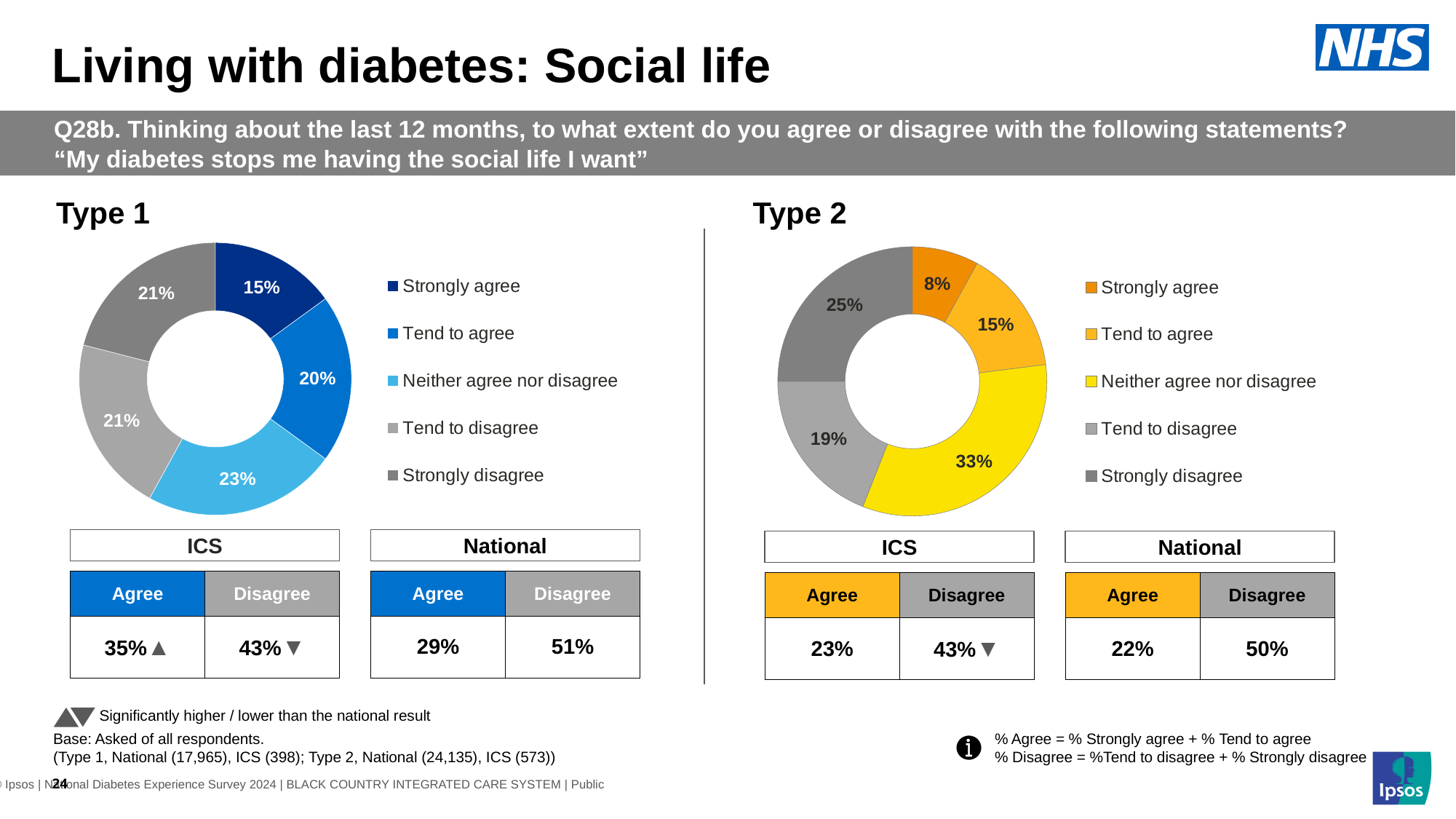
Which chart shows a larger share for 'Strongly agree', Type 1 or Type 2? Type 1 In the Type 1 chart, what percentage of respondents said 'Strongly agree'? 15% In the Type 1 chart, what percentage of respondents said 'Tend to agree'? 20% In the Type 2 chart, what percentage of respondents said 'Neither agree nor disagree'? 33% In the Type 2 chart, what is the difference in percentage points between 'Strongly disagree' and 'Tend to disagree'? 6 In the Type 2 chart, which response category has the largest share? Neither agree nor disagree What kind of chart is used to show the Type 2 responses? Donut chart How many response categories does the Type 1 chart's legend list? 5 In the Type 1 chart, what is the difference in percentage points between 'Neither agree nor disagree' and 'Strongly agree'? 8 In the Type 1 chart, which response category has the smallest share? Strongly agree In the Type 2 chart, which response category has the smallest share? Strongly agree In the Type 2 chart, what percentage of respondents said 'Strongly disagree'? 25%